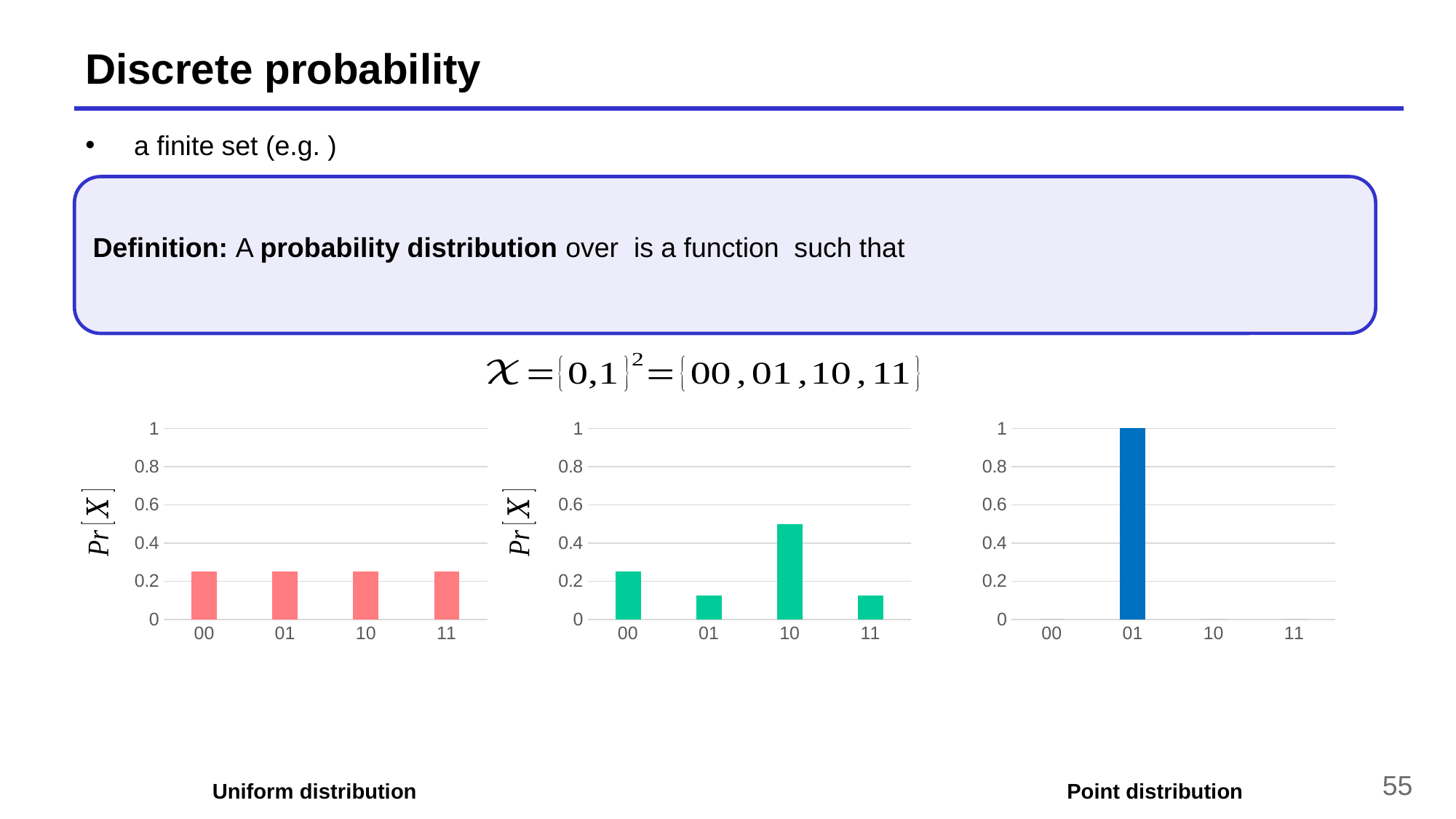
In the middle chart, is the value for 01 greater or less than 0.2? less In the middle chart, which category has the highest value? 10 What kind of chart is the left chart labelled Uniform distribution? bar chart In the right chart labelled Point distribution, what is the value for 01? 1 In the middle chart, is the value for 10 greater or less than 0.4? greater How many categories are shown on the x axis of the middle chart? 4 In the left chart labelled Uniform distribution, is the value for 11 greater or less than 0.4? less In the right chart labelled Point distribution, which category has the highest value? 01 In the middle chart, which is larger, the value for 00 or the value for 01? 00 What is the label of the y axis on the left chart? Pr[X] What caption appears below the right chart? Point distribution